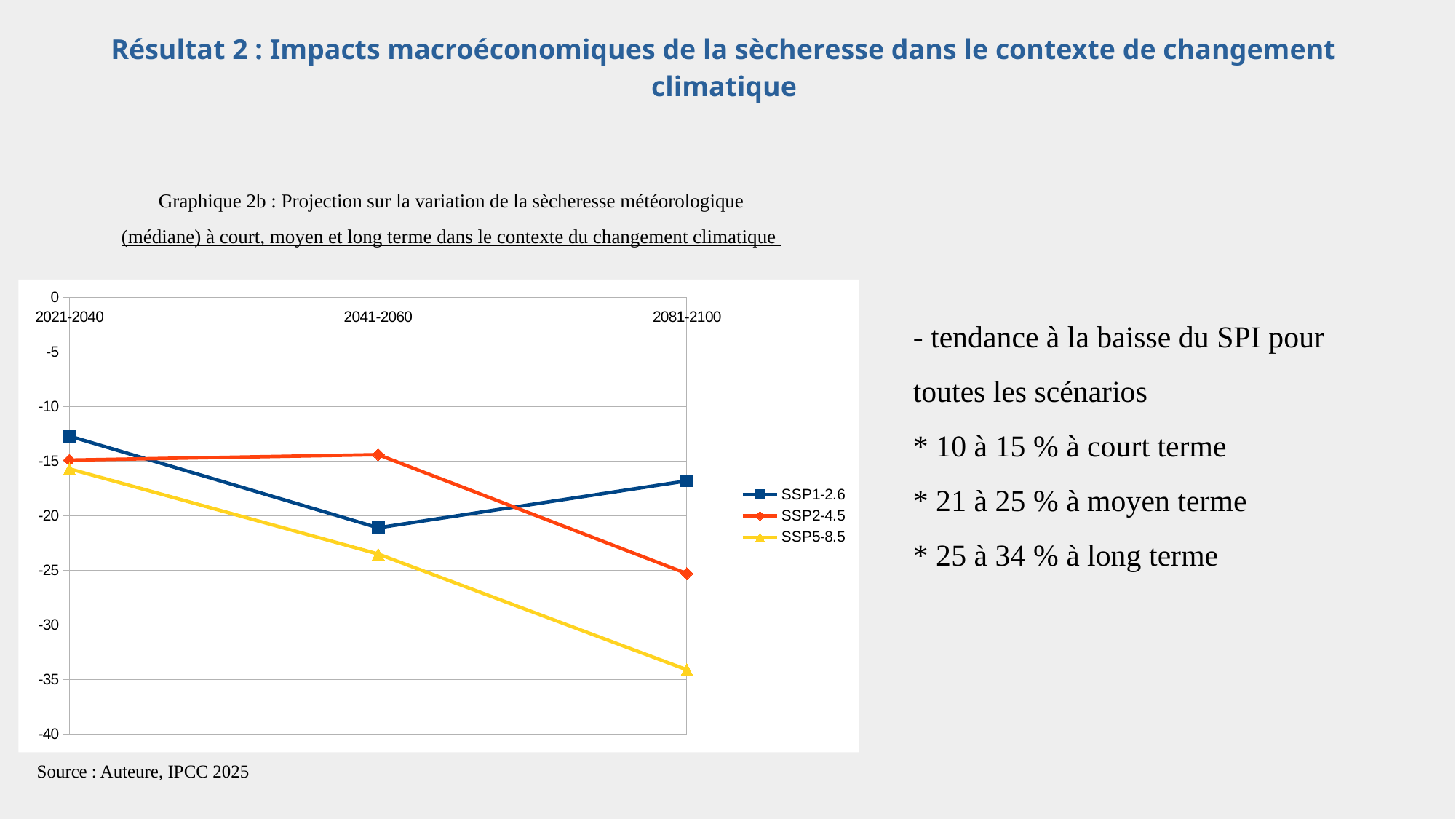
Do the values for SSP5-8.5 rise or fall from 2021-2040 to 2081-2100? fall Is the value for SSP5-8.5 in 2081-2100 greater or less than -30? less Is the value for SSP2-4.5 in 2081-2100 greater or less than -20? less How many time periods are shown on the x axis? 3 In 2081-2100, which is larger: the value for SSP1-2.6 or the value for SSP5-8.5? SSP1-2.6 Is the value for SSP1-2.6 in 2021-2040 greater or less than -15? greater How many series does the legend list? 3 What kind of chart is shown on the slide? line chart Which series has the highest value in 2041-2060? SSP2-4.5 Which colour is used for the SSP5-8.5 series? yellow Which series has the lowest value in 2081-2100? SSP5-8.5